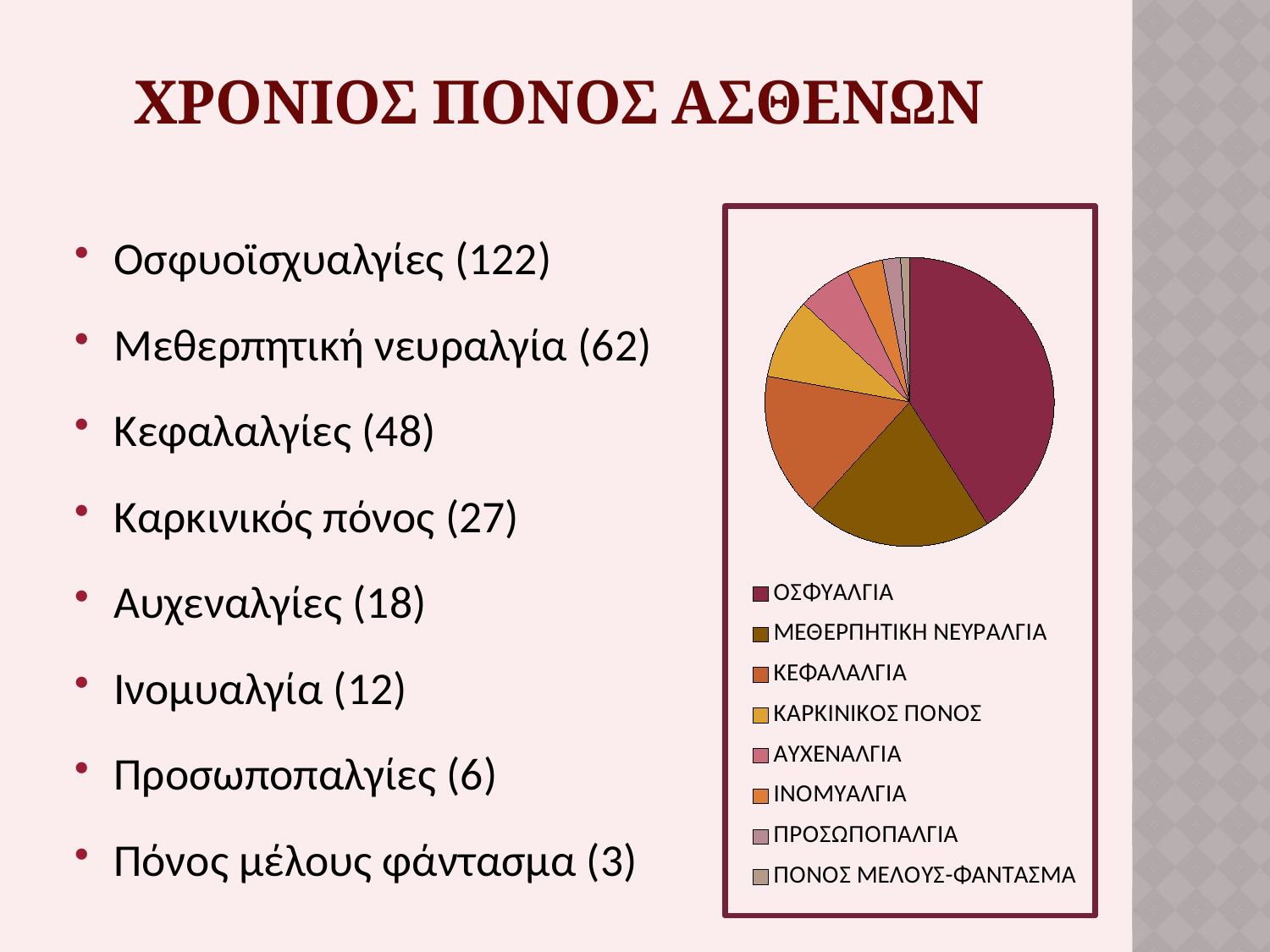
Which category has the smallest slice of the pie chart? ΠΟΝΟΣ ΜΕΛΟΥΣ-ΦΑΝΤΑΣΜΑ According to the slide, how many patients are in the ΜΕΘΕΡΠΗΤΙΚΗ ΝΕΥΡΑΛΓΙΑ category? 62 What colour is the ΟΣΦΥΑΛΓΙΑ slice in the pie chart? dark red / maroon According to the slide, how many patients are in the ΙΝΟΜΥΑΛΓΙΑ category? 12 Which category has the largest slice of the pie chart? ΟΣΦΥΑΛΓΙΑ Which slice is larger in the pie chart, ΜΕΘΕΡΠΗΤΙΚΗ ΝΕΥΡΑΛΓΙΑ or ΚΕΦΑΛΑΛΓΙΑ? ΜΕΘΕΡΠΗΤΙΚΗ ΝΕΥΡΑΛΓΙΑ How many categories does the pie chart's legend list? 8 What kind of chart is shown on the slide? pie chart According to the slide, how many patients are in the ΟΣΦΥΑΛΓΙΑ (Οσφυοϊσχυαλγίες) category? 122 Which slice is larger in the pie chart, ΚΑΡΚΙΝΙΚΟΣ ΠΟΝΟΣ or ΑΥΧΕΝΑΛΓΙΑ? ΚΑΡΚΙΝΙΚΟΣ ΠΟΝΟΣ What is the title of the slide containing the pie chart? ΧΡΟΝΙΟΣ ΠΟΝΟΣ ΑΣΘΕΝΩΝ What is the difference between the ΟΣΦΥΑΛΓΙΑ value (122) and the ΜΕΘΕΡΠΗΤΙΚΗ ΝΕΥΡΑΛΓΙΑ value (62) shown on the slide? 60